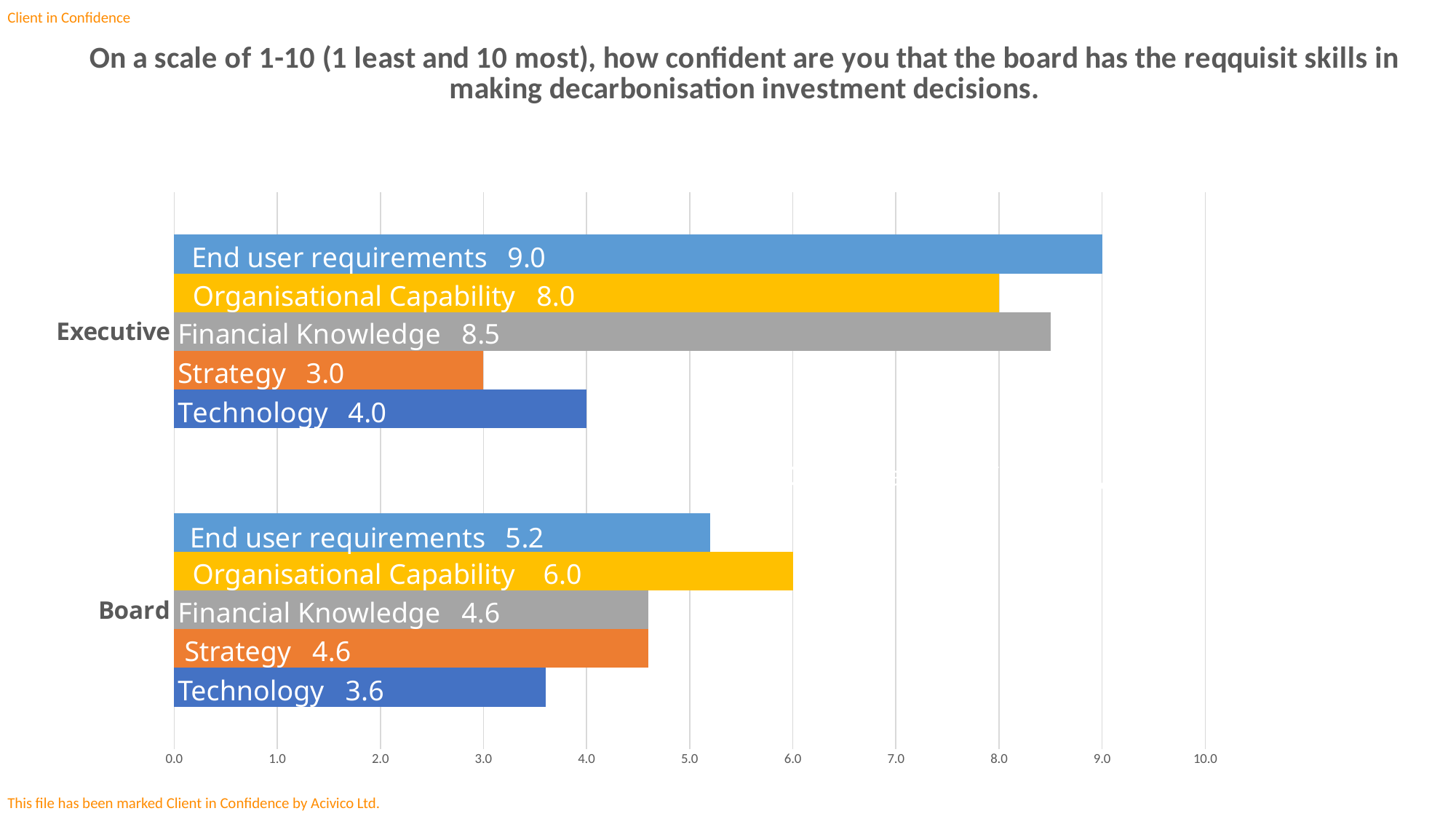
What type of chart is shown on the slide? Bar chart What is the Executive value for End user requirements? 9.0 Is the Board value for End user requirements greater or less than 5.0? greater How many series are plotted for each group? 5 Which series has the highest value for the Executive group? End user requirements What is the Executive value for Strategy? 3.0 How many groups (categories) are shown on the vertical axis? 2 What is the Board value for Organisational Capability? 6.0 Which series has the lowest value for the Board group? Technology Which is larger: the Executive value for Organisational Capability or the Executive value for Financial Knowledge? Financial Knowledge What is the difference between the Executive and Board values for Financial Knowledge? 3.9 What is the Board value for Technology? 3.6